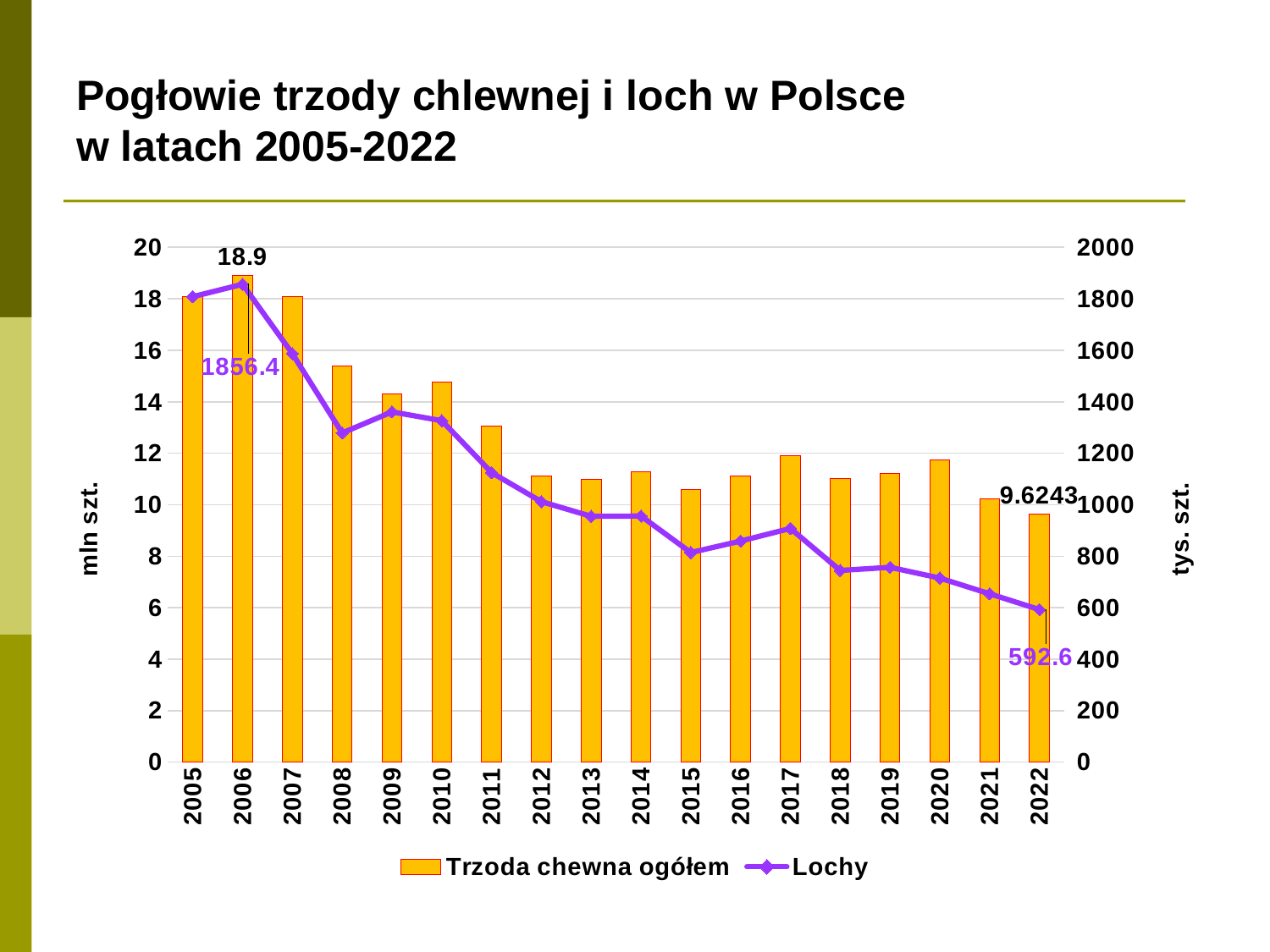
What is the value of the Trzoda chlewna ogółem bar for 2006? 18.9 How many years are shown on the x axis? 18 Which year has the lowest Trzoda chlewna ogółem bar? 2022 Which is larger, the Trzoda chlewna ogółem bar for 2017 or for 2015? 2017 By how much did the Lochy value fall from 2006 to 2022? 1263.8 Which year has the highest Trzoda chlewna ogółem bar? 2006 Is the Lochy value for 2015 greater or less than 1000? less What is the Lochy value for 2006? 1856.4 What is the Lochy value for 2022? 592.6 How many series does the legend list? 2 What is the value of the Trzoda chlewna ogółem bar for 2022? 9.6243 What is the overall trend of the Lochy line from 2005 to 2022? falling